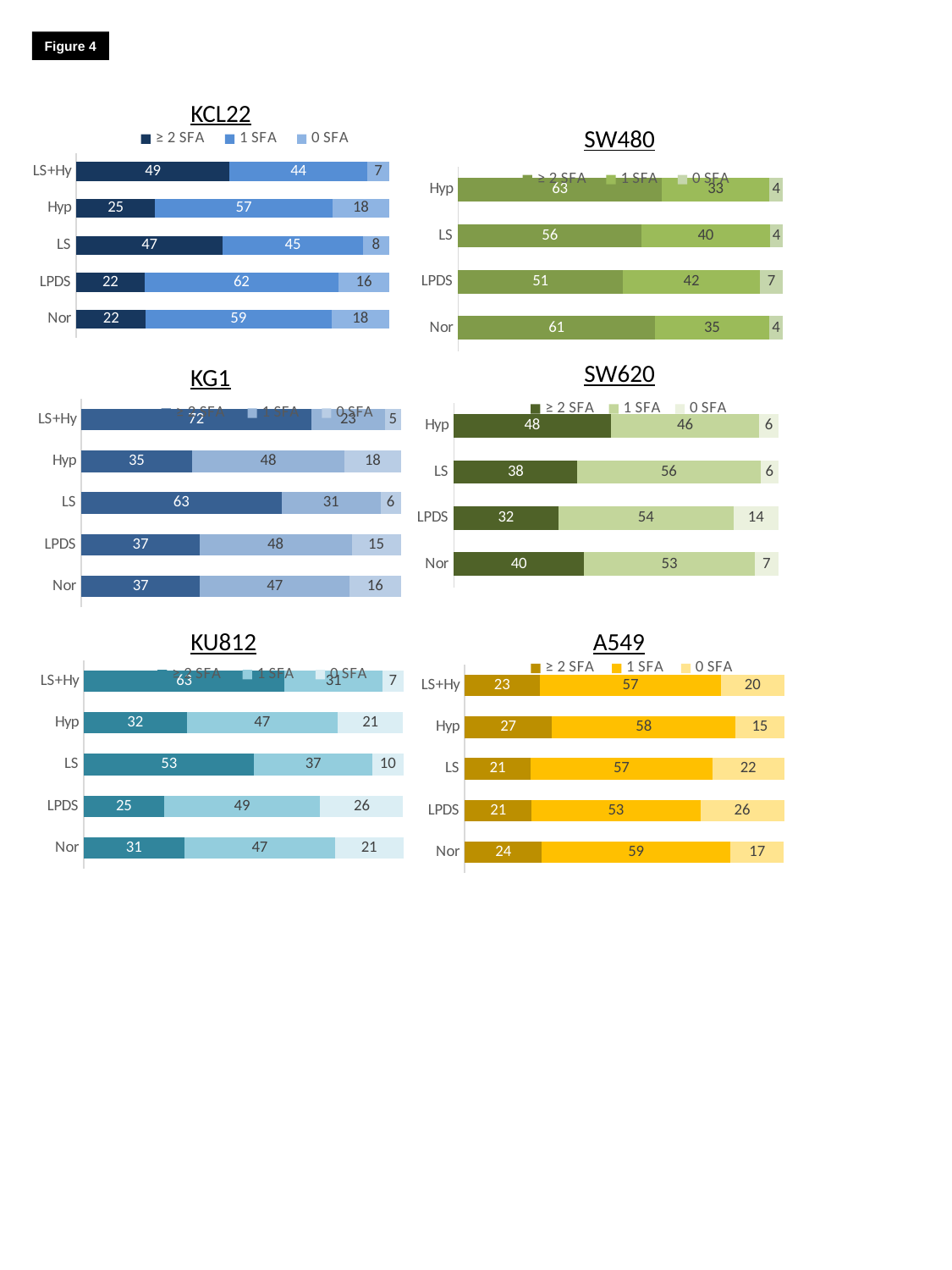
In the A549 chart, what is the total of the LS+Hy stacked bar? 100 In the KU812 chart, what is the difference between the 1 SFA value and the ≥ 2 SFA value for LPDS? 24 In the KCL22 chart, what is the ≥ 2 SFA value for LS+Hy? 49 In the KCL22 chart, which category has the highest 1 SFA value? LPDS In the SW620 chart, what is the 0 SFA value for LPDS? 14 What kind of chart is the KCL22 chart? Stacked bar chart In the A549 chart, which category has the lowest 0 SFA value? Hyp In the KG1 chart, which category has the highest ≥ 2 SFA value? LS+Hy In the KU812 chart, what is the 0 SFA value for Nor? 21 How many series does the legend of the SW620 chart list? 3 In the SW480 chart, how many categories are shown on the vertical axis? 4 In the SW480 chart, which is larger: the ≥ 2 SFA value for Hyp or for Nor? Hyp